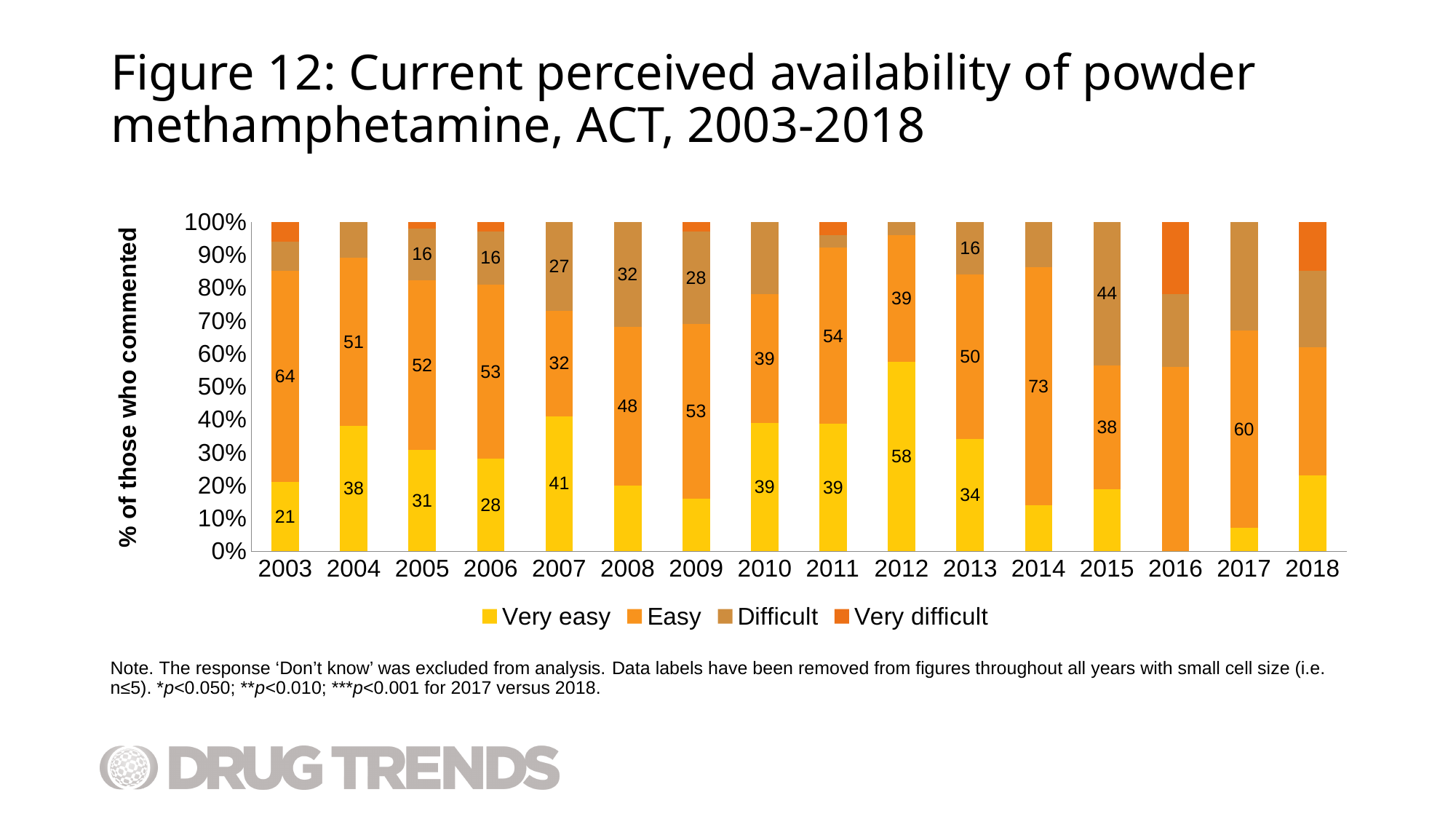
What kind of chart is shown on the slide? Stacked bar chart What is the data label for the Difficult segment in 2015? 44 What is the data label for the Easy segment in 2014? 73 Is the Very easy segment in 2017 greater or less than 10%? less What is the data label for the Very easy segment in 2012? 58 In 2007, what is the difference between the Very easy label and the Easy label? 9 How many years are shown on the x axis? 16 Which is larger, the Easy label in 2003 or the Easy label in 2004? 2003 Which year has the largest Very easy segment? 2012 How many series does the legend list? 4 What is the data label for the Easy segment in 2003? 64 What is the data label for the Difficult segment in 2008? 32